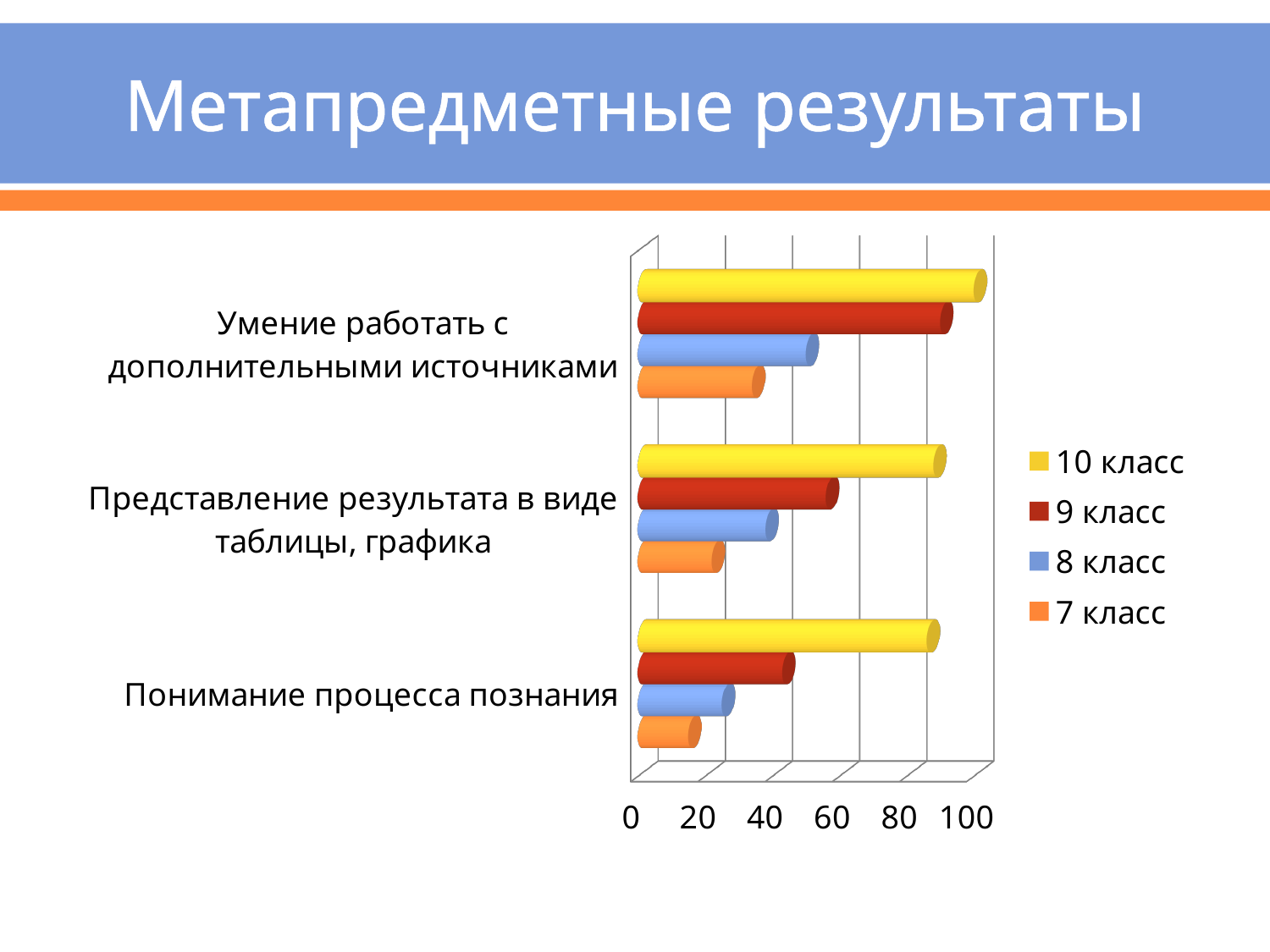
How many series does the legend list? 4 Is the value for "7 класс" in "Понимание процесса познания" greater or less than 20? less How many categories are shown on the chart? 3 What kind of chart is shown on the slide? bar chart For the series "7 класс", which category has the lowest value? Понимание процесса познания Which series has the lowest value for "Умение работать с дополнительными источниками"? 7 класс Is the value for "9 класс" in "Понимание процесса познания" greater or less than 60? less Which is larger for "Представление результата в виде таблицы, графика": the value for "9 класс" or for "8 класс"? 9 класс For the series "7 класс", which category has the highest value? Умение работать с дополнительными источниками Is the value for "9 класс" in "Умение работать с дополнительными источниками" greater or less than 80? greater Which series has the highest value for "Понимание процесса познания"? 10 класс Which colour represents the series "10 класс" in the legend? yellow